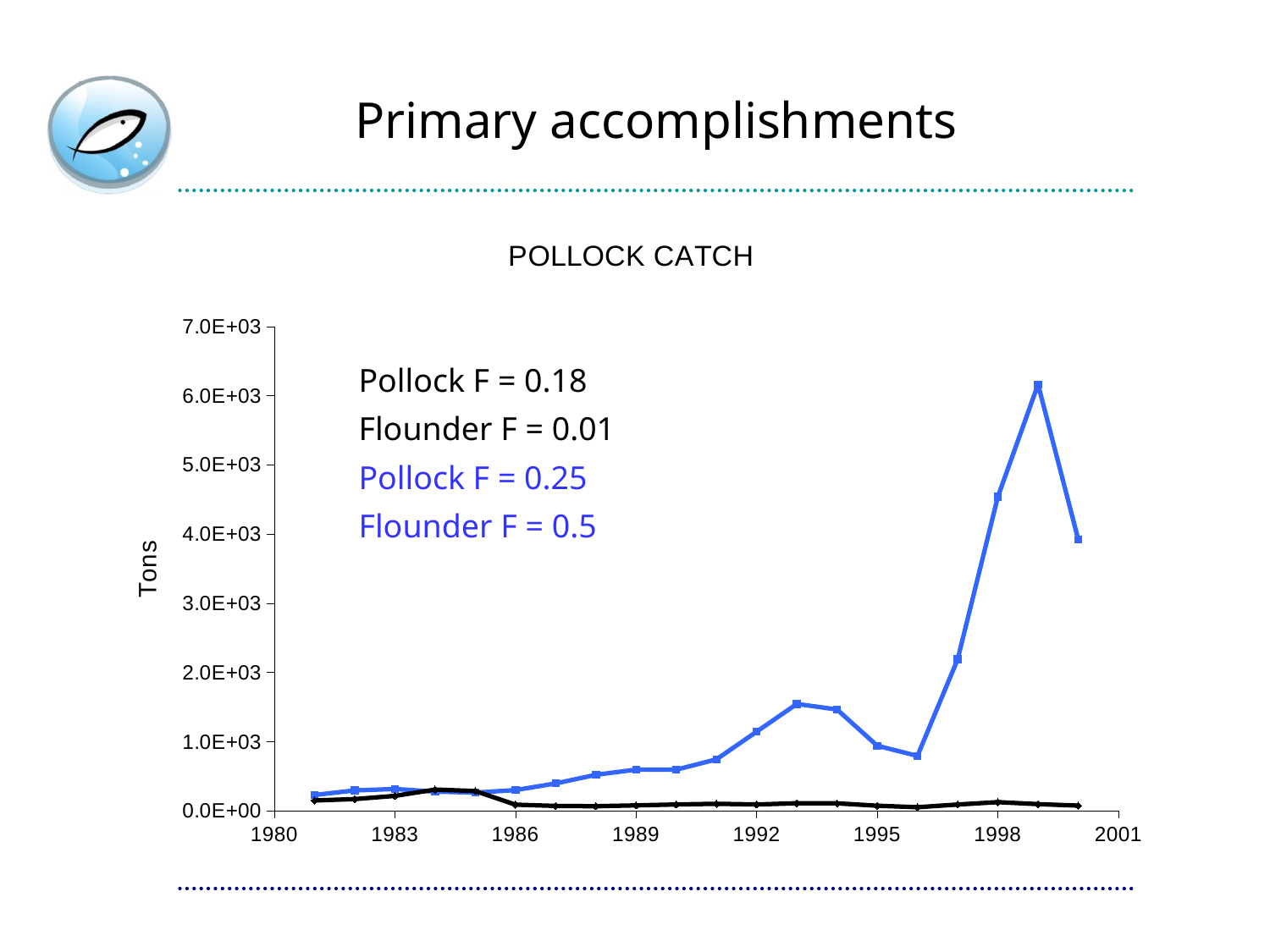
Is the value of the blue line in 1999 greater or less than 5.0E+03? greater Is the value of the blue line in 1998 greater or less than 4.0E+03? greater Which line is higher in 1999, the blue line or the black line? the blue line What kind of chart is shown on the slide? line chart Is the value of the black line in 1999 greater or less than 1.0E+03? less What is the title of the chart? POLLOCK CATCH In which year does the blue line (Pollock F = 0.25, Flounder F = 0.5) reach its highest value? 1999 What is the label of the y axis? Tons Does the blue line rise or fall between 1996 and 1999? rise Does the blue line rise or fall between 1999 and 2000? fall How many lines (series) are plotted on the chart? 2